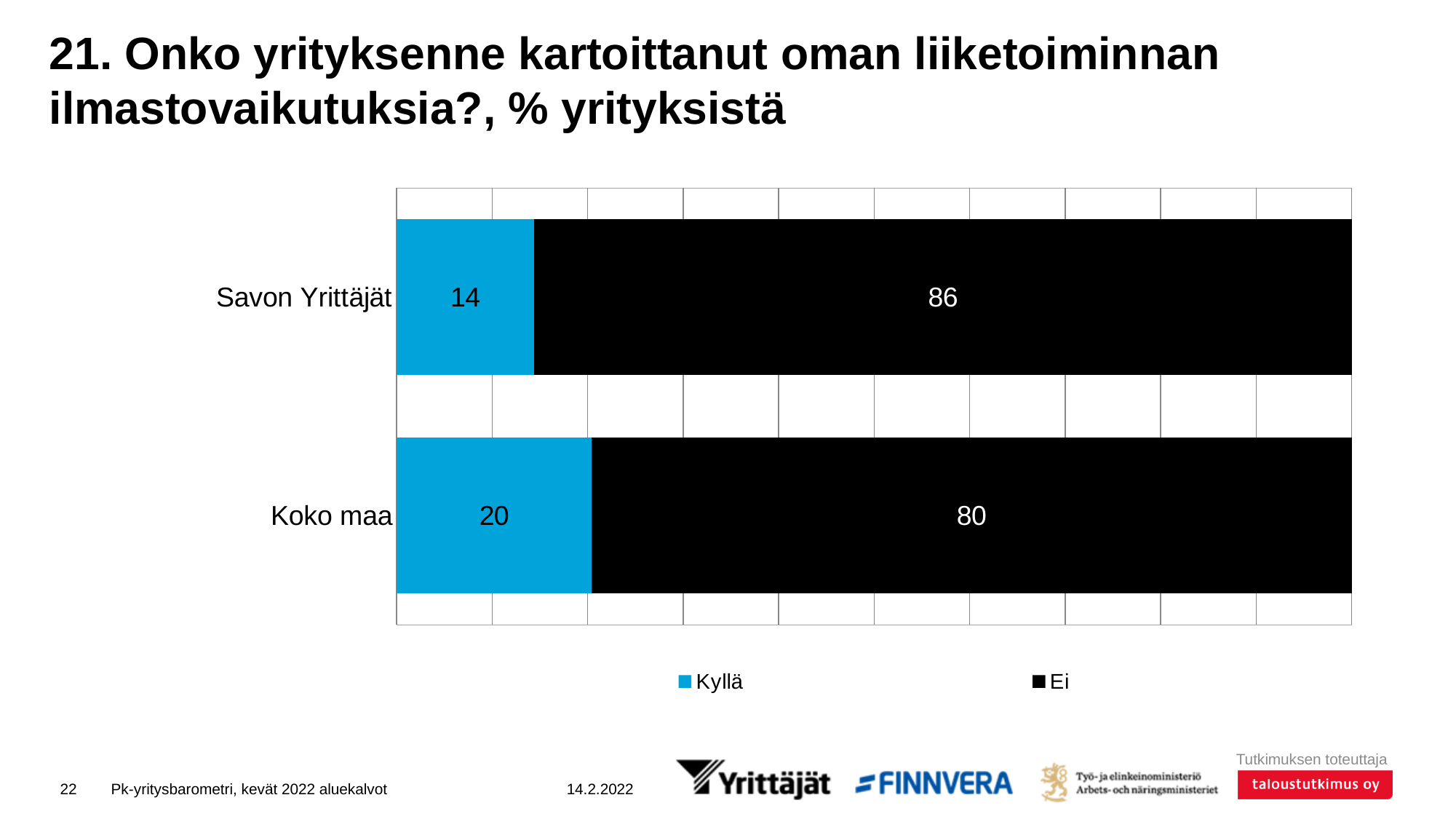
How many series does the legend list? 2 What is the difference between the Ei values for Savon Yrittäjät and Koko maa? 6 What kind of chart is shown on the slide? Stacked horizontal bar chart What is the total of the stacked bar for Savon Yrittäjät? 100 What is the value for Ei for Savon Yrittäjät? 86 Which category has the highest Ei value? Savon Yrittäjät Which category has the higher Kyllä value, Savon Yrittäjät or Koko maa? Koko maa What is the difference between the Kyllä values for Koko maa and Savon Yrittäjät? 6 How many categories are shown on the chart? 2 What is the value for Kyllä for Koko maa? 20 What is the value for Ei for Koko maa? 80 What is the value for Kyllä for Savon Yrittäjät? 14